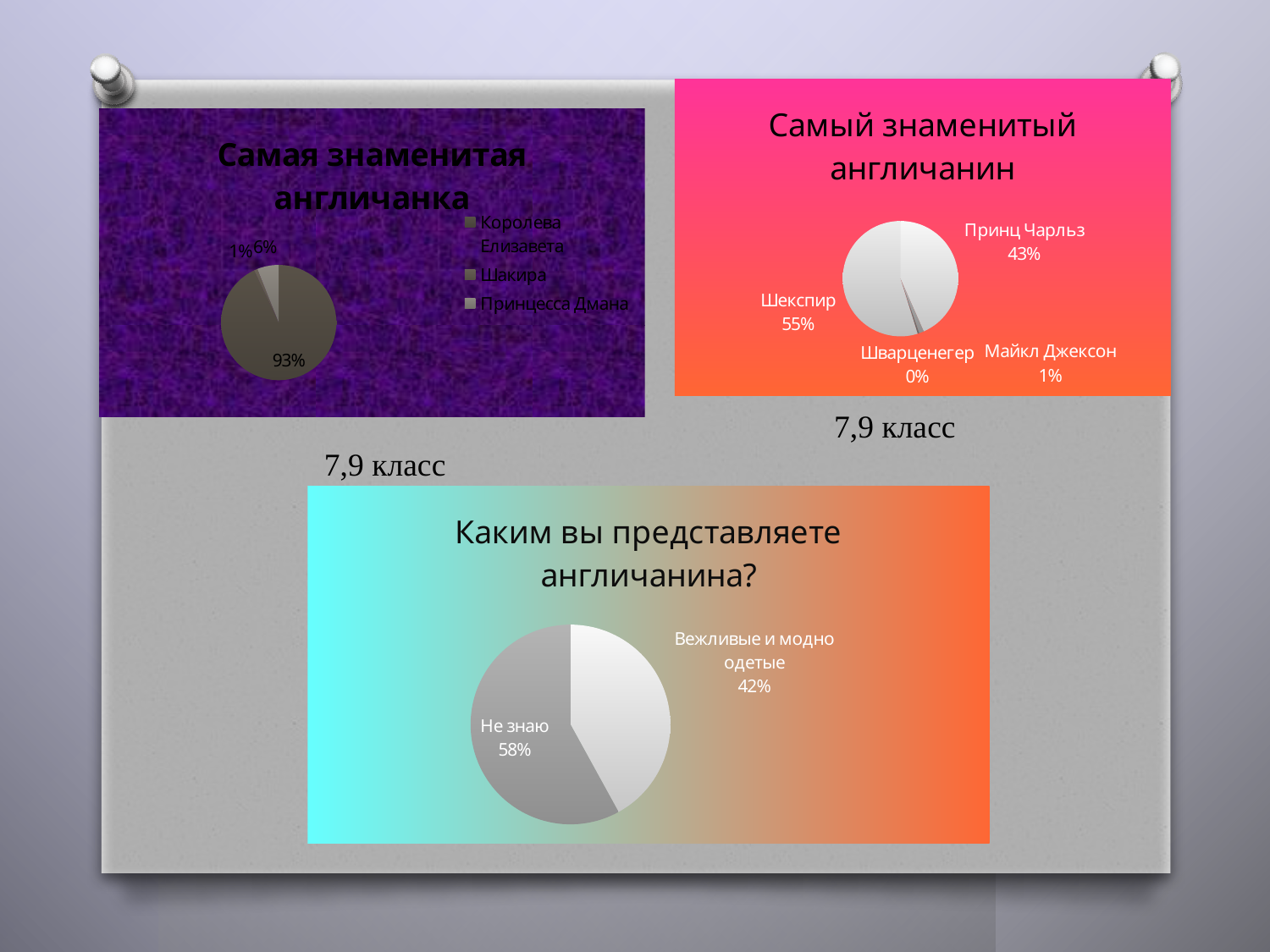
On the chart titled "Самый знаменитый англичанин", what is the difference between the shares of Шекспир and Принц Чарльз? 12% On the chart titled "Самый знаменитый англичанин", what share does Шекспир have? 55% On the chart titled "Самый знаменитый англичанин", which category has the largest share? Шекспир On the chart titled "Самый знаменитый англичанин", how many categories are shown? 4 On the chart titled "Самая знаменитая англичанка", what is the largest percentage shown? 93% On the chart titled "Самый знаменитый англичанин", which category has the smallest share? Шварценегер On the chart titled "Каким вы представляете англичанина?", which is larger: "Не знаю" or "Вежливые и модно одетые"? Не знаю On the chart titled "Каким вы представляете англичанина?", what kind of chart is shown? Pie chart On the chart titled "Самый знаменитый англичанин", what share does Майкл Джексон have? 1% On the chart titled "Самая знаменитая англичанка", how many entries does the legend list? 3 On the chart titled "Каким вы представляете англичанина?", what share does "Не знаю" have? 58% On the chart titled "Самый знаменитый англичанин", what share does Принц Чарльз have? 43%